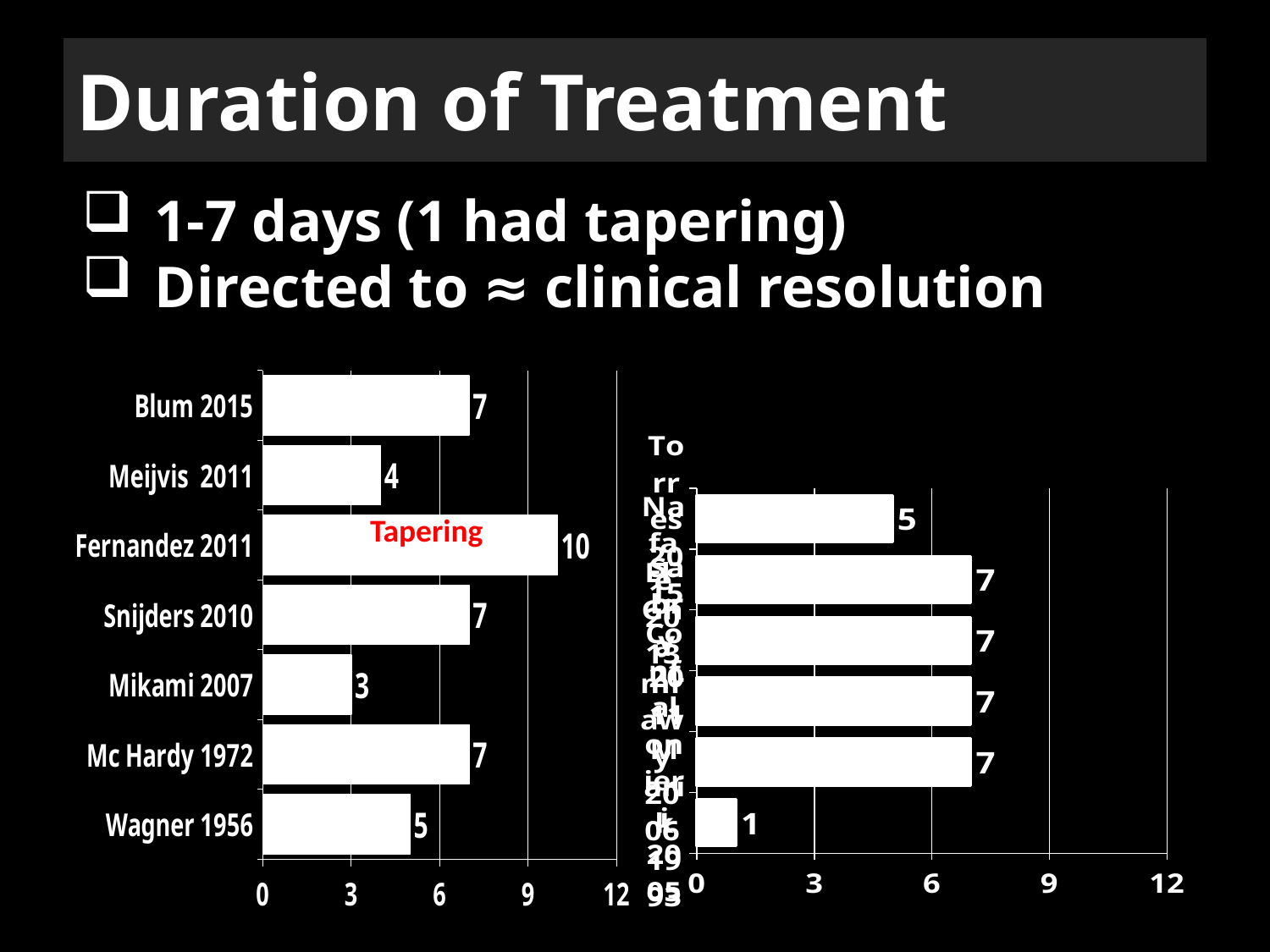
On the left chart, which study has the highest value? Fernandez 2011 On the left chart, which bar carries the red label "Tapering"? Fernandez 2011 On the left chart, what is the value for Fernandez 2011? 10 On the right chart, how many bars are plotted? 6 On the left chart, what is the difference between the values for Fernandez 2011 and Meijvis 2011? 6 On the left chart, which is larger, the value for Blum 2015 or the value for Wagner 1956? Blum 2015 On the left chart, what is the value for Mikami 2007? 3 On the left chart, which study has the lowest value? Mikami 2007 On the left chart, what is the value for Wagner 1956? 5 What kind of chart is the left chart? bar chart On the left chart, how many studies are plotted? 7 On the right chart, what is the value of the bottom bar? 1